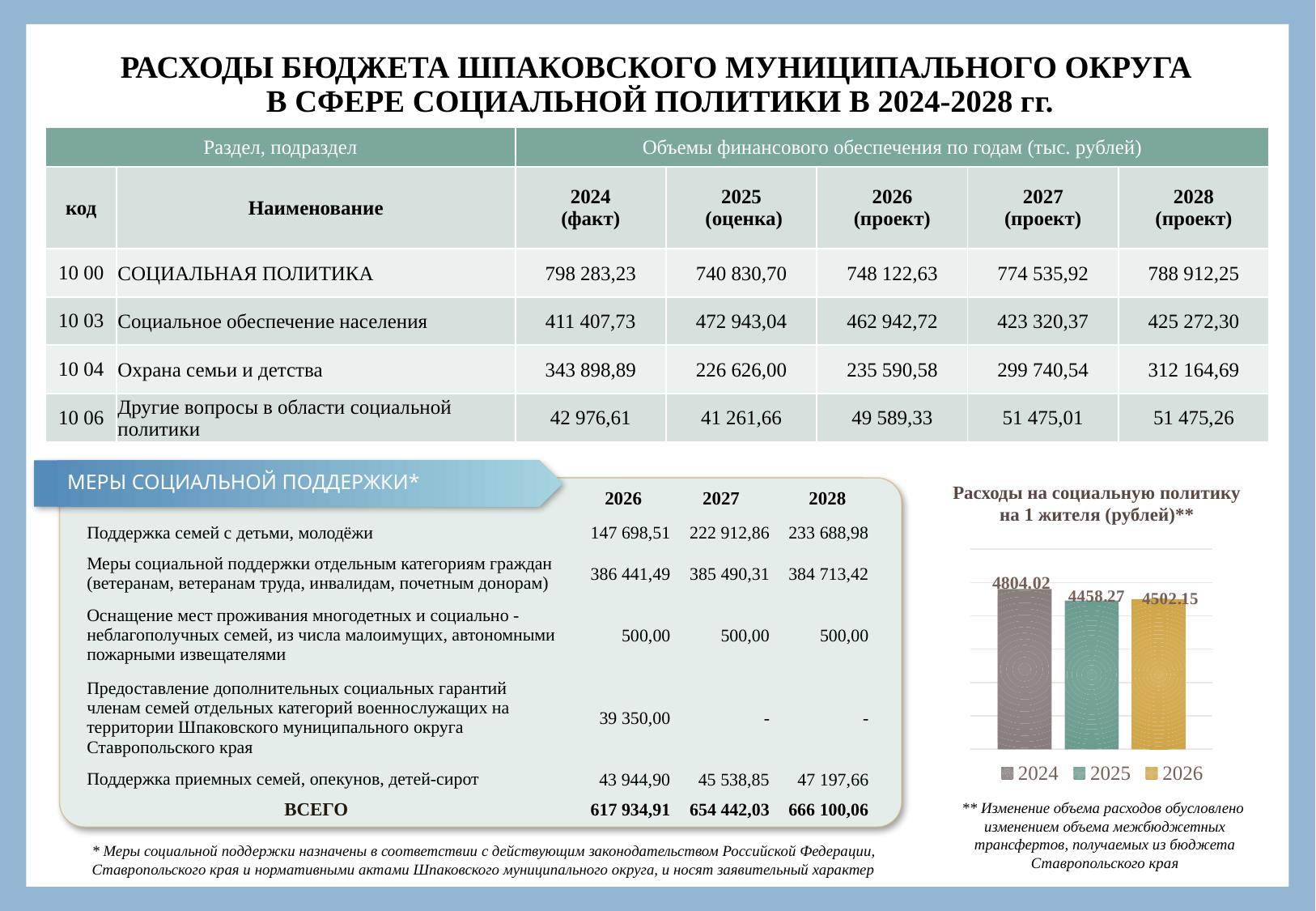
How many bars are plotted in the chart 'Расходы на социальную политику на 1 жителя (рублей)'? 3 In the chart 'Расходы на социальную политику на 1 жителя (рублей)', which year has the lowest value? 2025 In the chart 'Расходы на социальную политику на 1 жителя (рублей)', what is the difference between the 2024 and 2025 values? 345.75 What kind of chart is 'Расходы на социальную политику на 1 жителя (рублей)'? bar chart What is the value for 2025 in the chart 'Расходы на социальную политику на 1 жителя (рублей)'? 4458.27 What is the value for 2024 in the chart 'Расходы на социальную политику на 1 жителя (рублей)'? 4804.02 In the chart 'Расходы на социальную политику на 1 жителя (рублей)', what is the difference between the 2026 and 2025 values? 43.88 What is the value for 2026 in the chart 'Расходы на социальную политику на 1 жителя (рублей)'? 4502.15 In the chart 'Расходы на социальную политику на 1 жителя (рублей)', which year has the highest value? 2024 In the chart 'Расходы на социальную политику на 1 жителя (рублей)', which legend entry is shown in yellow? 2026 In the chart 'Расходы на социальную политику на 1 жителя (рублей)', which is larger: the value for 2024 or the value for 2026? 2024 How many entries does the legend of the chart 'Расходы на социальную политику на 1 жителя (рублей)' list? 3